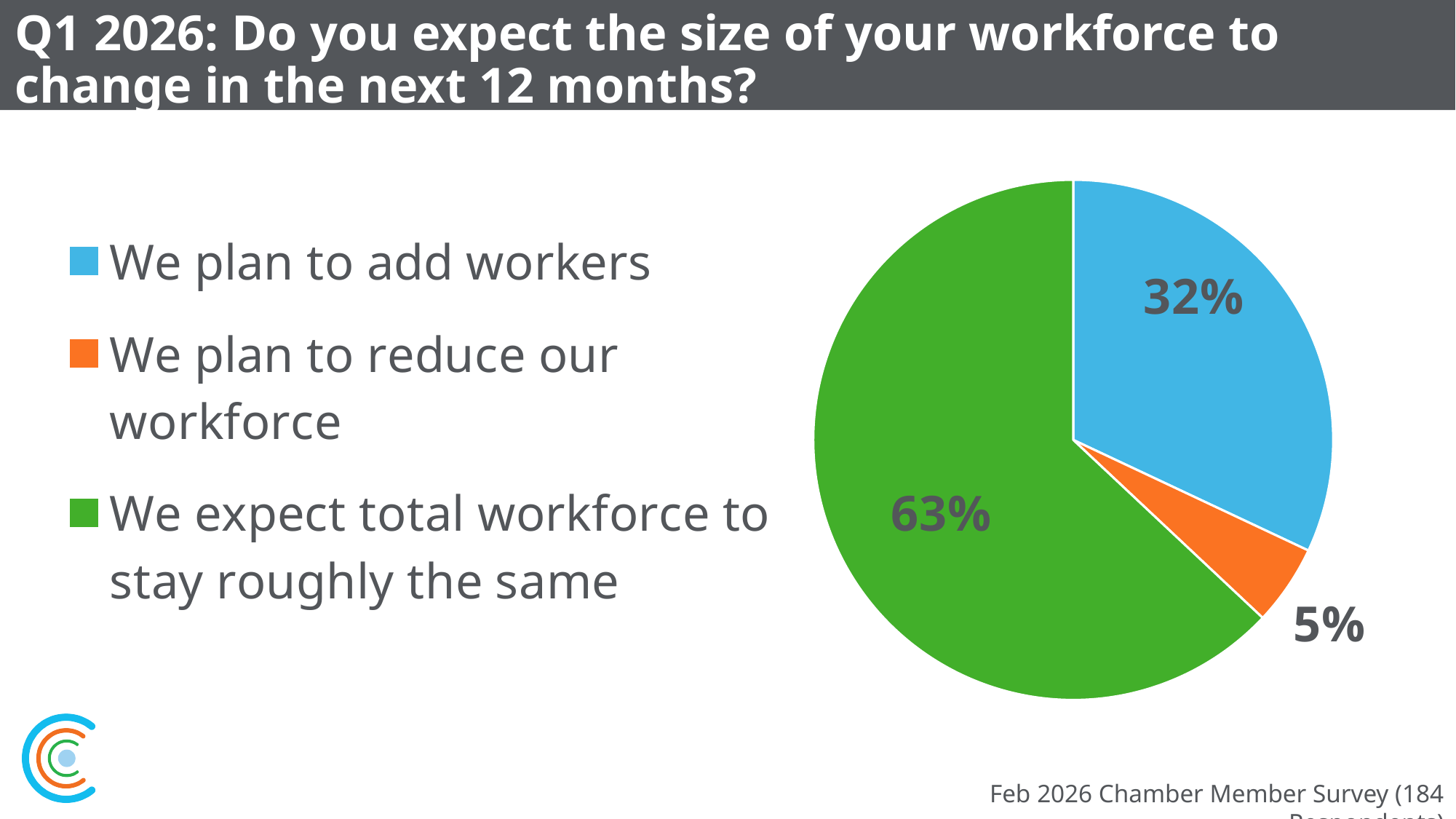
What colour is the slice for 'We plan to reduce our workforce'? Orange Which is larger: the share planning to add workers or the share planning to reduce their workforce? We plan to add workers What share of respondents said they plan to add workers? 32% How many respondents does the survey source note cite? 184 What is the difference in percentage points between the share planning to add workers and the share planning to reduce their workforce? 27 How many response categories are shown in the pie chart? 3 What share of respondents said they plan to reduce their workforce? 5% What is the difference in percentage points between the share expecting workforce to stay roughly the same and the share planning to add workers? 31 Which response has the smallest share of the pie? We plan to reduce our workforce What kind of chart is shown on the slide? Pie chart What share of respondents expect total workforce to stay roughly the same? 63% Which response has the largest share of the pie? We expect total workforce to stay roughly the same